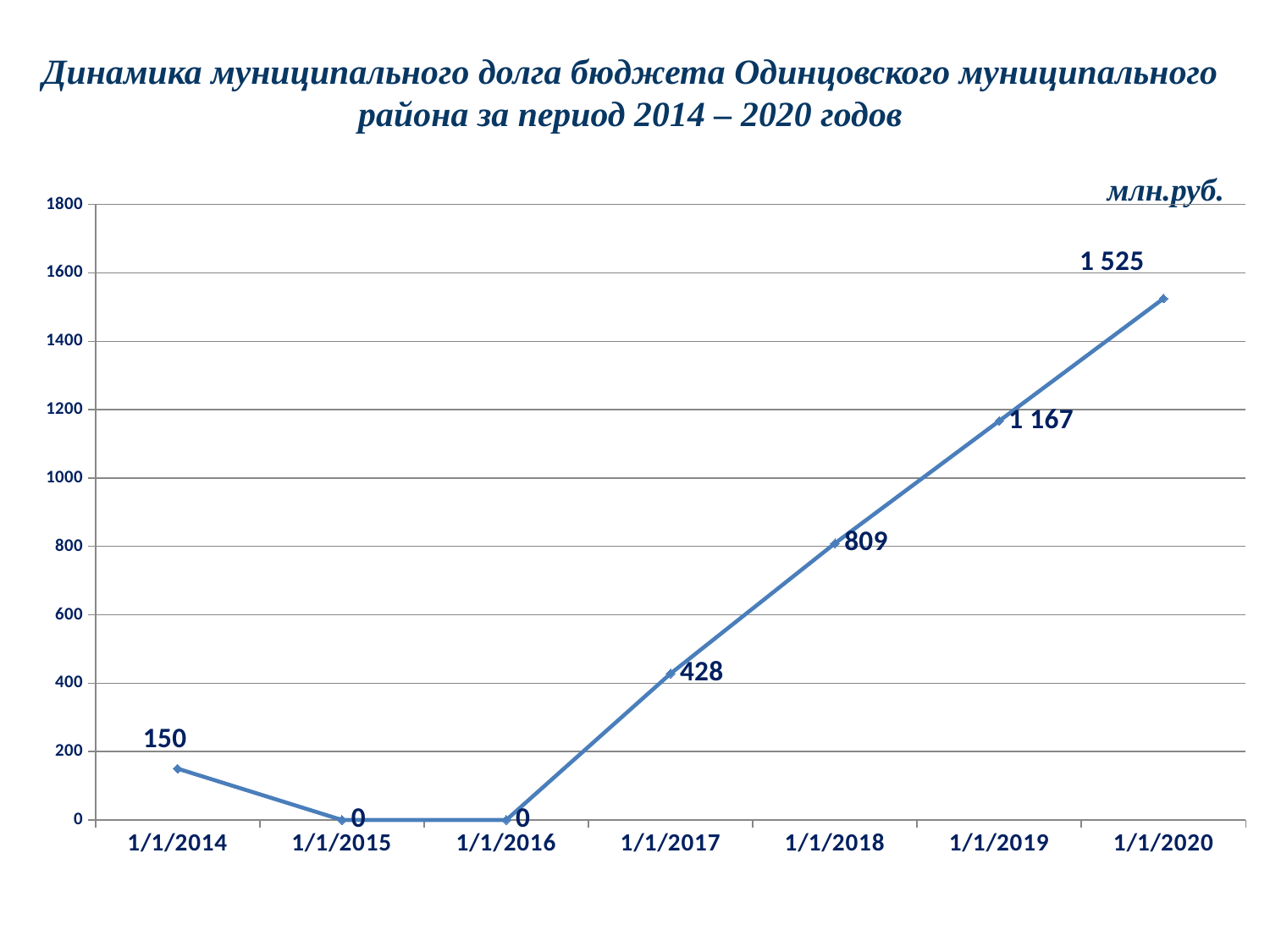
What is the value for 1/1/2017? 428 What is the difference between the values for 1/1/2018 and 1/1/2017? 381 What kind of chart is shown on the slide? line chart What is the value for 1/1/2014? 150 What is the value for 1/1/2018? 809 Which is larger, the value for 1/1/2014 or the value for 1/1/2017? 1/1/2017 What is the difference between the values for 1/1/2020 and 1/1/2019? 358 Do the values rise or fall from 1/1/2016 to 1/1/2020? rise Which date has the highest value? 1/1/2020 How many data points are plotted on the chart? 7 What is the value for 1/1/2019? 1 167 What is the value for 1/1/2020? 1 525